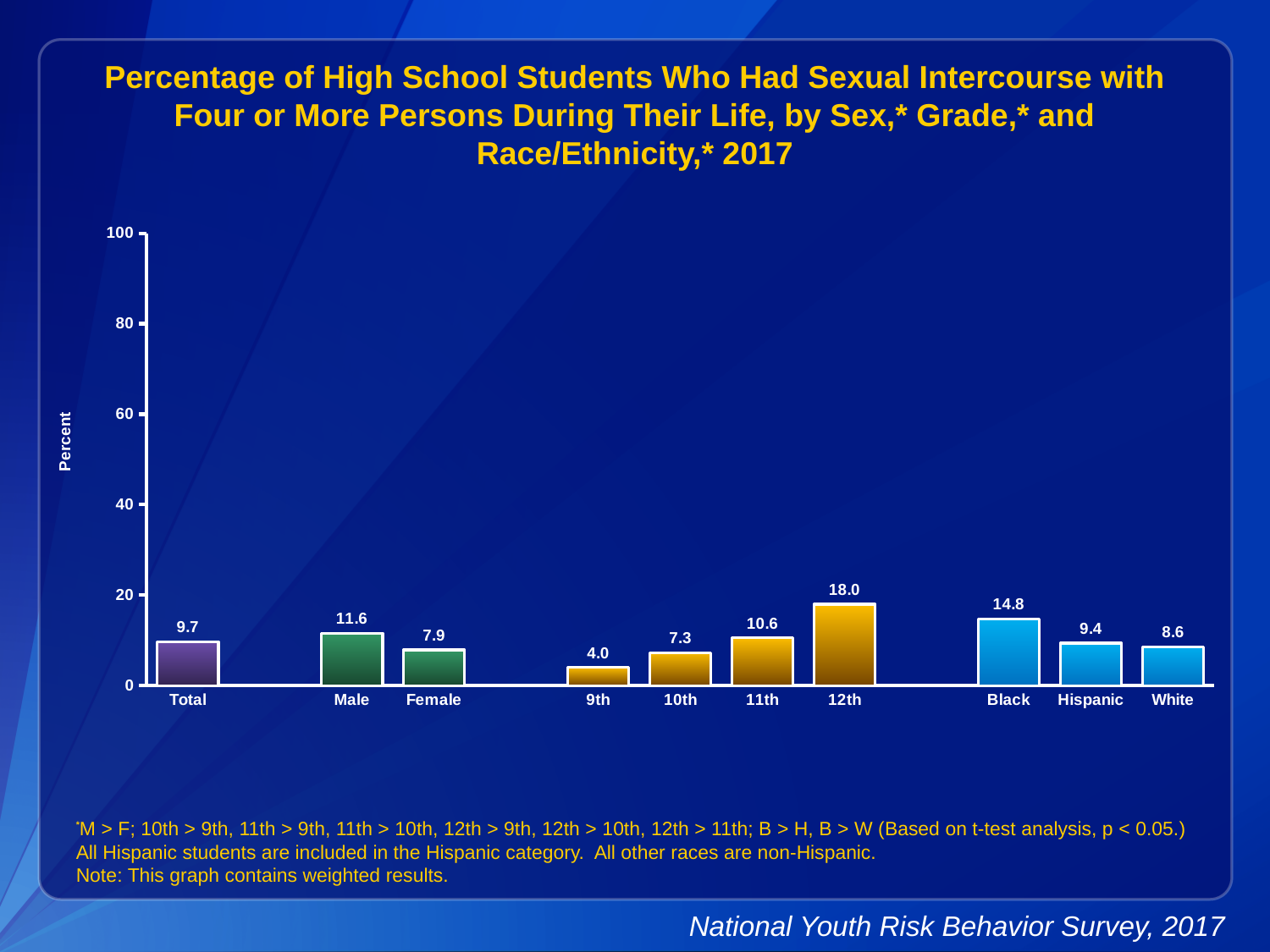
What is the value for Hispanic students? 9.4 Is the value for 12th grade greater or less than 20? less What is the value for 12th grade? 18.0 Which is larger, the value for 11th grade or the value for 10th grade? 11th What is the difference between the values for Male and Female? 3.7 What kind of chart is this? bar chart Which category has the highest value? 12th Do the values rise or fall from 9th grade to 12th grade? rise How many categories are shown on the x axis? 10 Which category has the lowest value? 9th What is the difference between the values for Black and White students? 6.2 What is the value for Total? 9.7